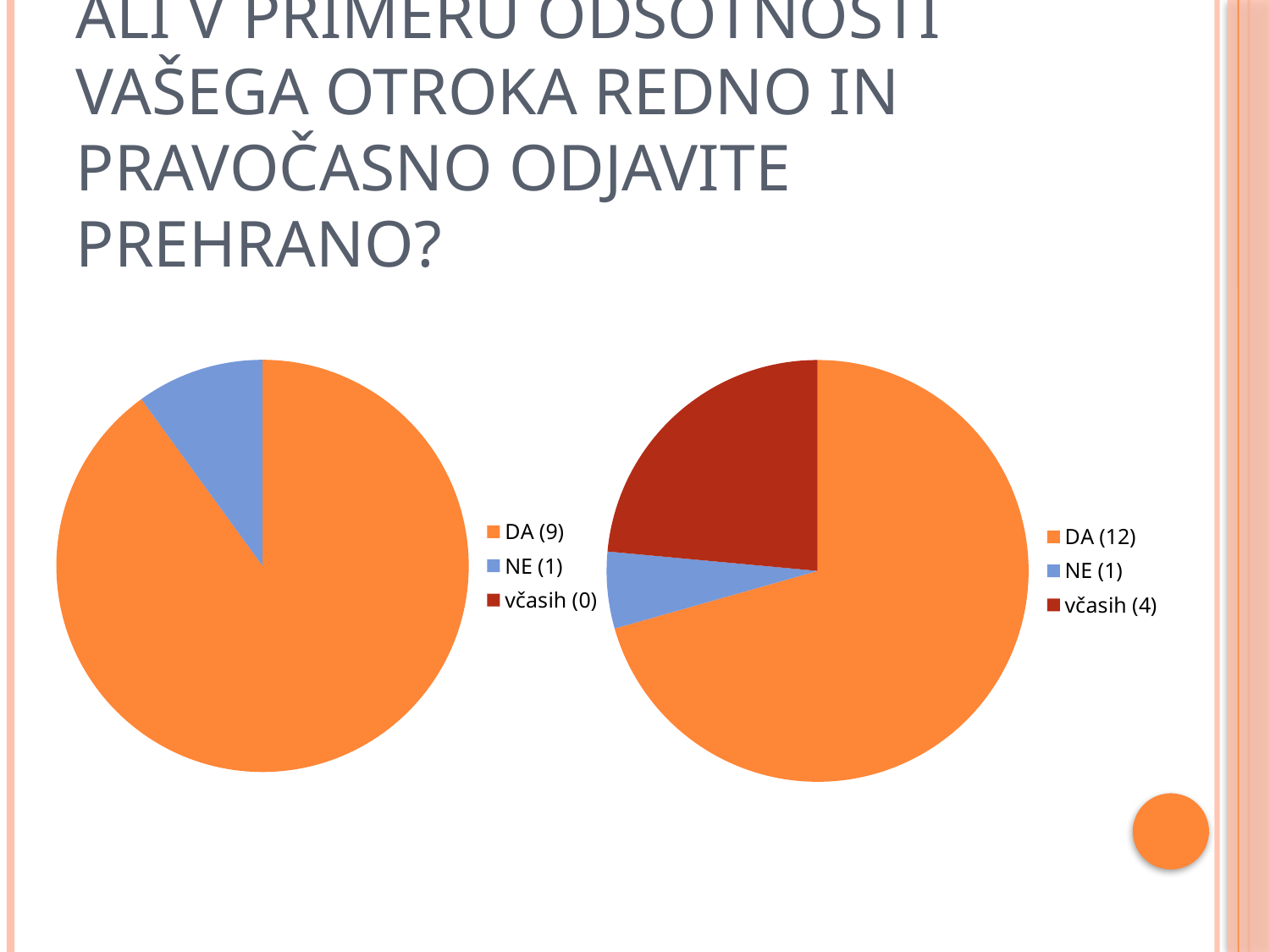
In the left pie chart, what share of the total does DA represent? 90% In the left pie chart, what is the value for DA? 9 In the right pie chart, which is larger, the value for NE or the value for včasih? včasih What type of chart is the left chart on the slide? pie chart In the right pie chart, which category has the smallest value? NE In the right pie chart, what is the difference between the values for DA and včasih? 8 In the right pie chart, what is the value for DA? 12 In the right pie chart, which category has the largest value? DA In the right pie chart, what is the value for včasih? 4 How many categories does the legend of the right pie chart list? 3 In the left pie chart, what is the value for NE? 1 In the left pie chart, what is the value for včasih? 0